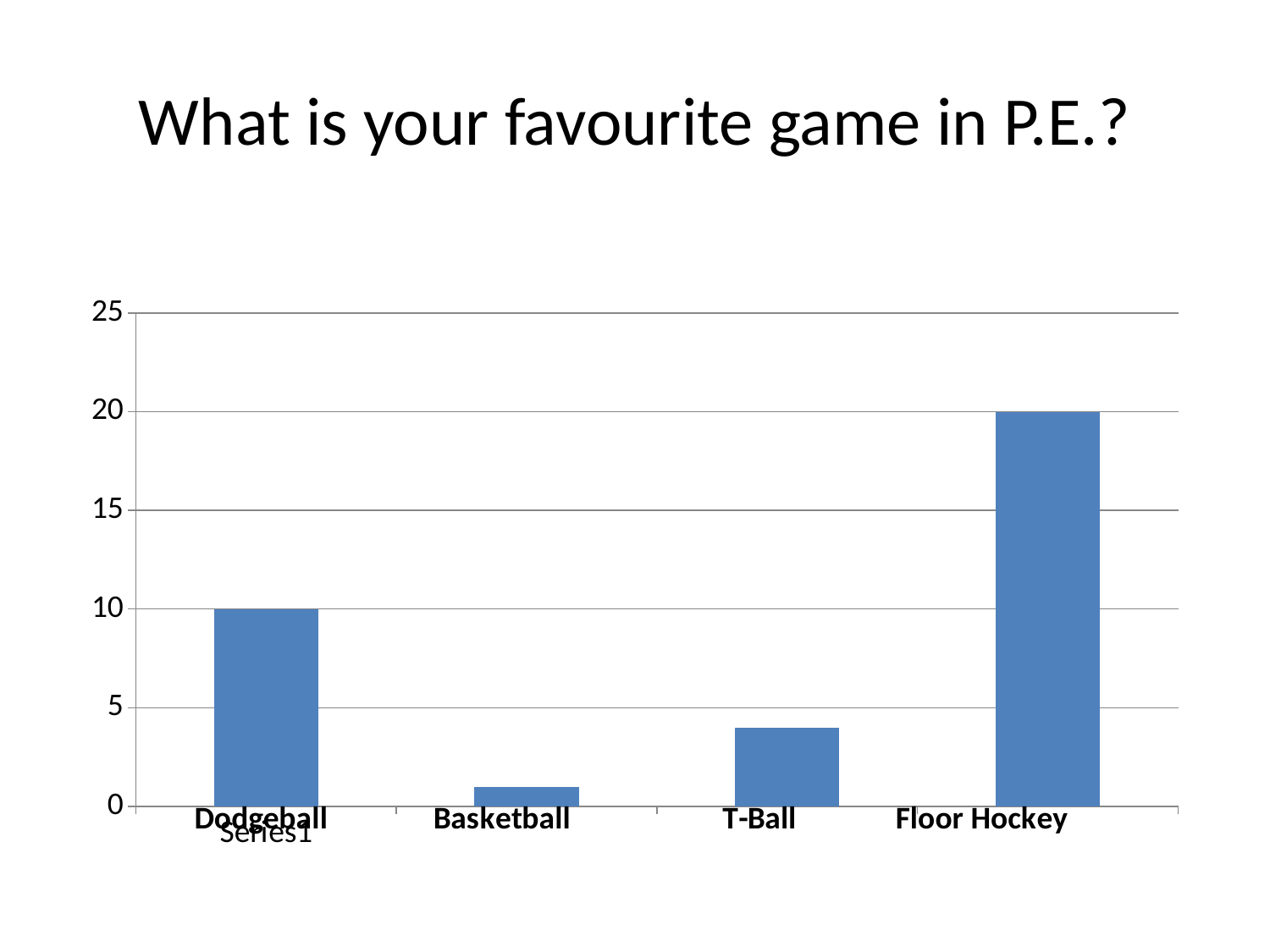
What is the value for Dodgeball? 10 How many categories are shown on the x axis? 4 Which is larger, the value for T-Ball or the value for Dodgeball? Dodgeball Which category has the lowest value? Basketball Which category has the highest value? Floor Hockey Is the value for Floor Hockey greater or less than 15? greater What is the difference between the values for Floor Hockey and Dodgeball? 10 Is the value for T-Ball greater or less than 5? less What kind of chart is shown on the slide? bar chart Is the value for Basketball greater or less than 5? less What is the title of the slide? What is your favourite game in P.E.? What is the value for Floor Hockey? 20